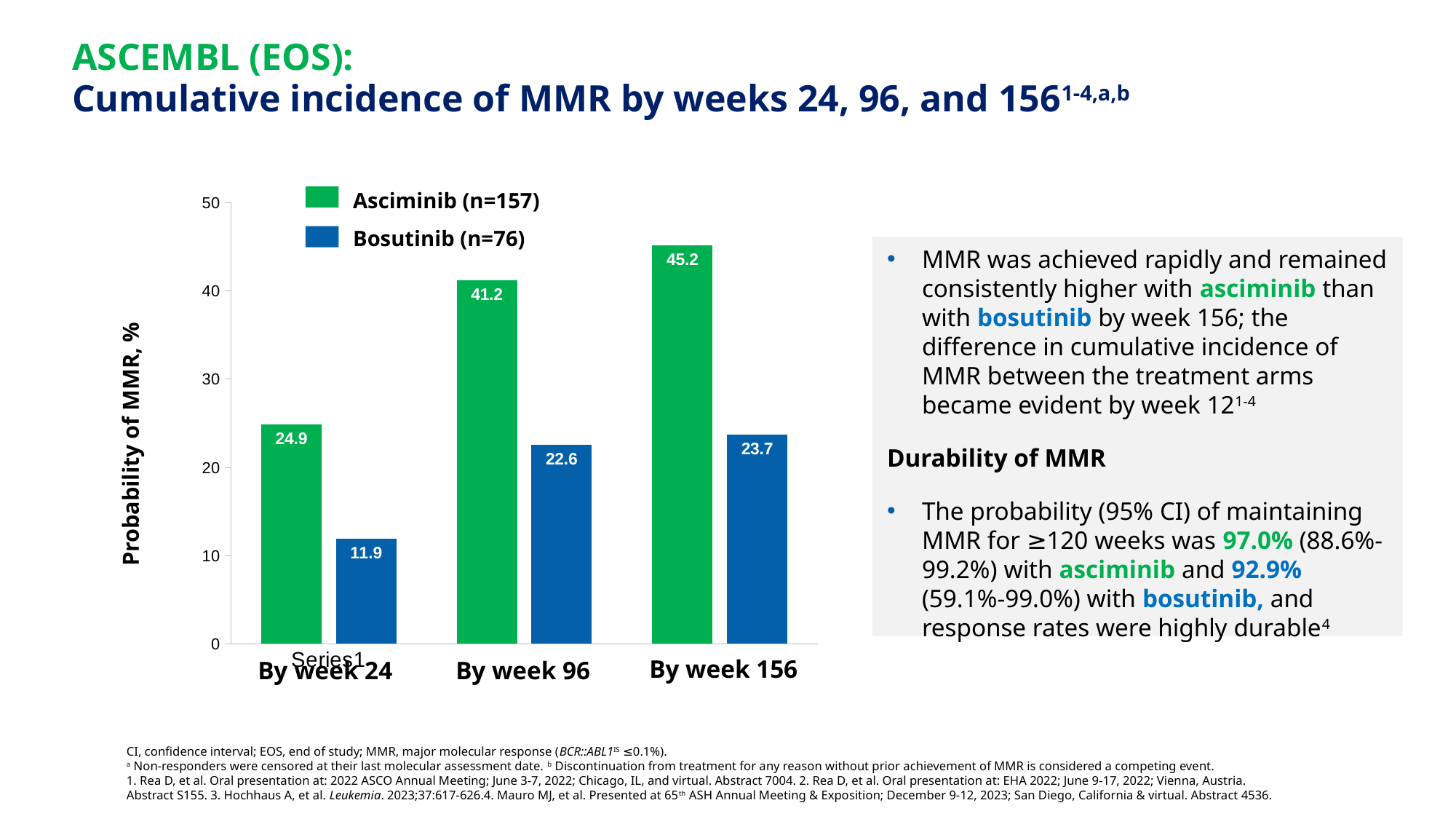
What is the probability of MMR for asciminib by week 24? 24.9 Which is larger by week 96, asciminib or bosutinib? Asciminib Which time point has the highest value for asciminib? By week 156 What is the difference between asciminib and bosutinib by week 156? 21.5 What is the probability of MMR for bosutinib by week 156? 23.7 Do the asciminib values rise or fall from week 24 to week 156? Rise What is the probability of MMR for bosutinib by week 96? 22.6 Which time point has the lowest value for bosutinib? By week 24 How many series does the legend list? 2 How many time points are shown on the x axis? 3 What kind of chart is shown? Bar chart What is the difference between asciminib and bosutinib by week 24? 13.0